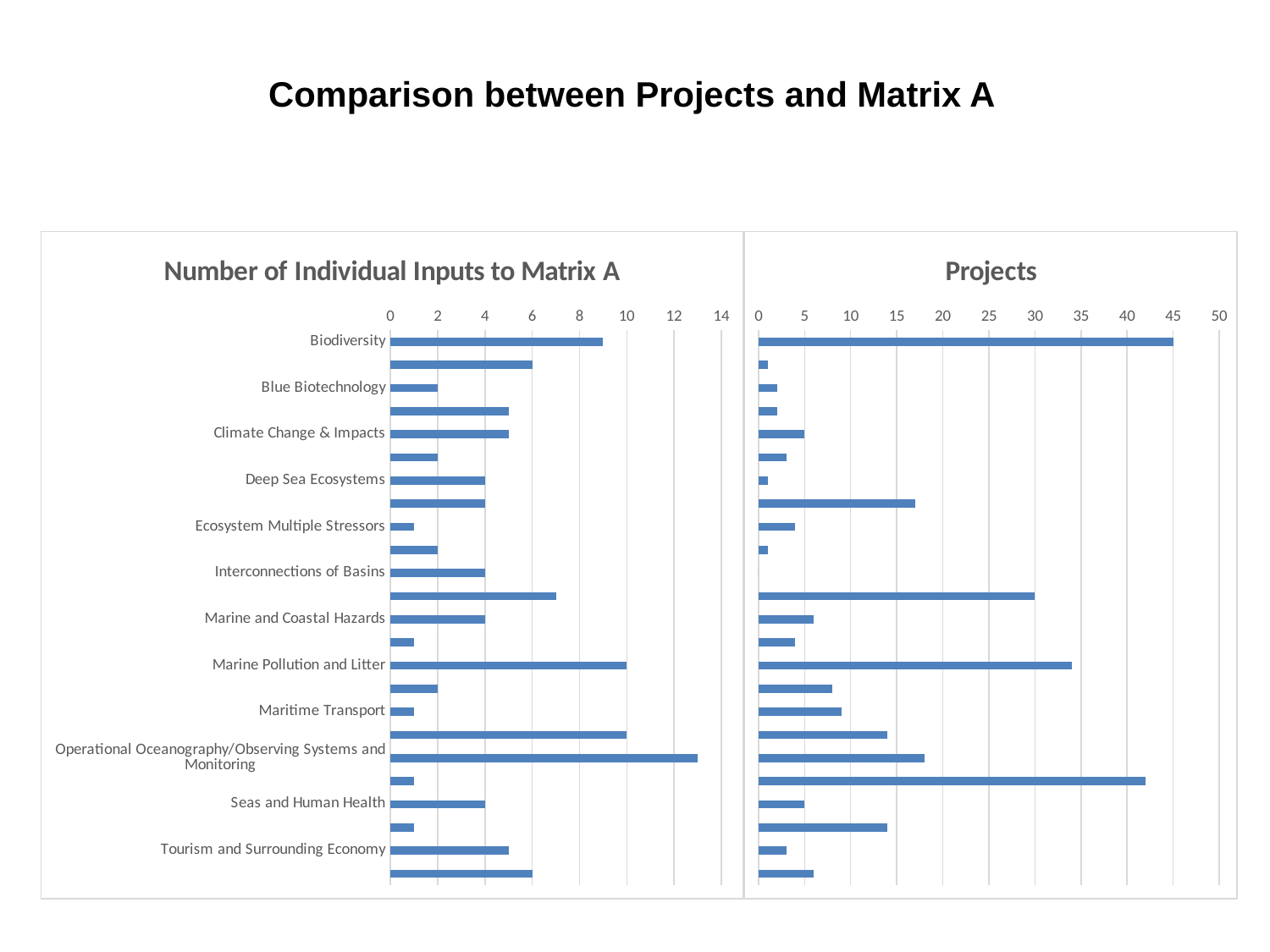
In the "Projects" chart, which labeled category has the highest value? Biodiversity In the "Number of Individual Inputs to Matrix A" chart, which is larger, Biodiversity or Climate Change & Impacts? Biodiversity In the "Projects" chart, is the value for Tourism and Surrounding Economy greater or less than 5? less In the "Number of Individual Inputs to Matrix A" chart, what is the value for Marine Pollution and Litter? 10 In the "Projects" chart, is the value for Maritime Transport greater or less than 5? greater What kind of chart is the "Number of Individual Inputs to Matrix A" chart on the left? bar chart In the "Projects" chart, what is the value for Interconnections of Basins? 0 In the "Number of Individual Inputs to Matrix A" chart, is the value for Operational Oceanography/Observing Systems and Monitoring greater or less than 12? greater In the "Projects" chart, which is larger, Marine Pollution and Litter or Interconnections of Basins? Marine Pollution and Litter What is the title of the chart on the right side of the slide? Projects In the "Projects" chart, what is the value for Biodiversity? 45 In the "Number of Individual Inputs to Matrix A" chart, which labeled category has the highest value? Operational Oceanography/Observing Systems and Monitoring